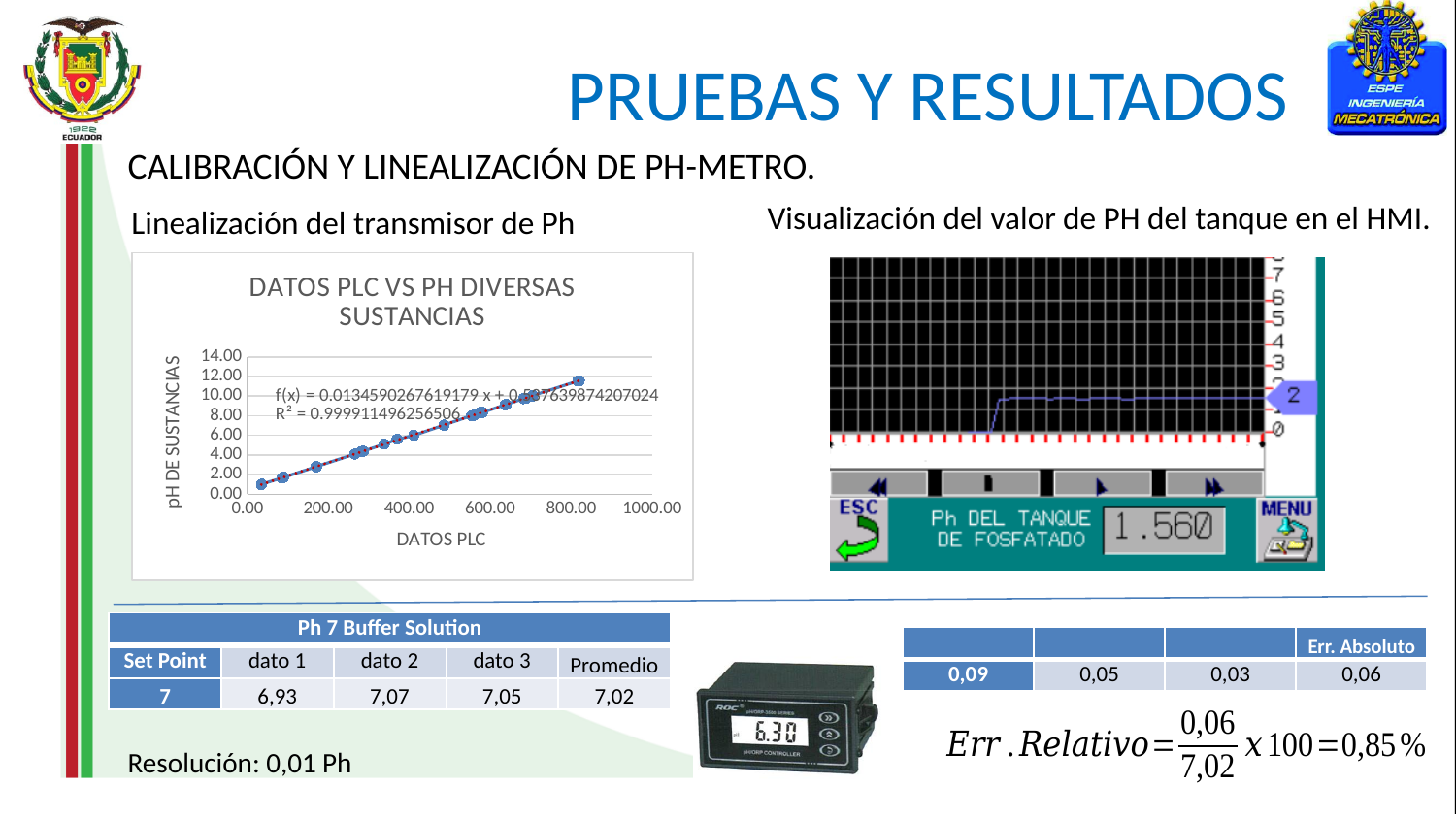
In the chart 'DATOS PLC VS PH DIVERSAS SUSTANCIAS', what is the label of the x axis? DATOS PLC What is the title of the chart on the left side of the slide? DATOS PLC VS PH DIVERSAS SUSTANCIAS In the chart 'DATOS PLC VS PH DIVERSAS SUSTANCIAS', is the pH value of the point with the largest DATOS PLC value greater or less than 10.00? greater In the chart 'DATOS PLC VS PH DIVERSAS SUSTANCIAS', is the pH value of the point with the smallest DATOS PLC value greater or less than 2.00? less In the chart 'DATOS PLC VS PH DIVERSAS SUSTANCIAS', what is the highest tick value shown on the y axis? 14.00 In the chart 'DATOS PLC VS PH DIVERSAS SUSTANCIAS', what is the highest tick value shown on the x axis? 1000.00 In the chart 'DATOS PLC VS PH DIVERSAS SUSTANCIAS', what R² value is shown for the trendline? 0.999911496256506 In the chart 'DATOS PLC VS PH DIVERSAS SUSTANCIAS', do the pH values rise or fall as DATOS PLC increases? rise What type of chart is 'DATOS PLC VS PH DIVERSAS SUSTANCIAS'? scatter chart In the chart 'DATOS PLC VS PH DIVERSAS SUSTANCIAS', what is the slope coefficient of x in the trendline equation? 0.0134590267619179